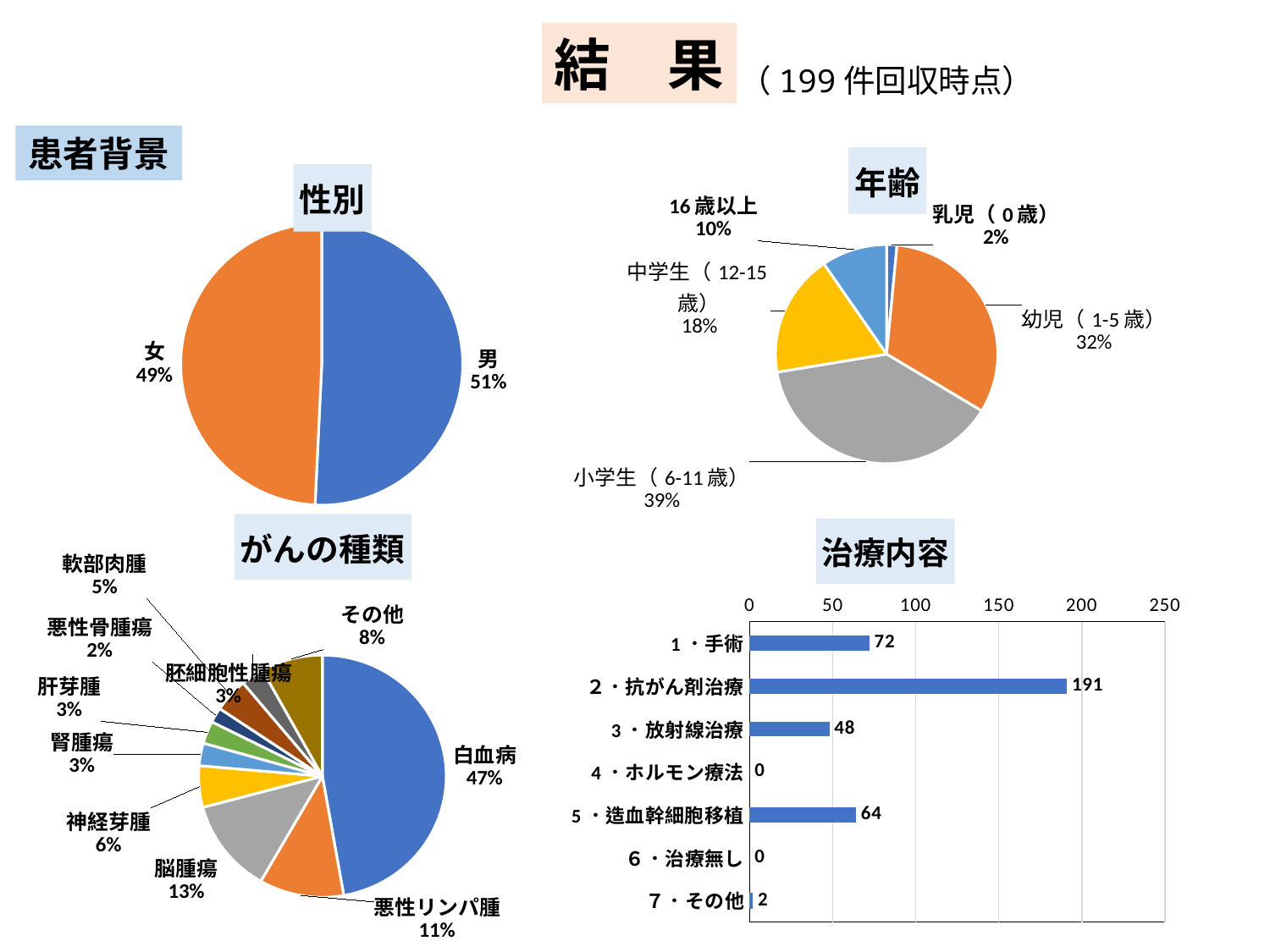
In the 年齢 pie chart, what is the difference in percentage points between 幼児（1-5歳） and 中学生（12-15歳）? 14 In the がんの種類 pie chart, what percentage is 白血病? 47% In the 治療内容 chart, what is the difference between 1・手術 and 5・造血幹細胞移植? 8 In the 性別 pie chart, which slice is larger, 男 or 女? 男 What kind of chart is the 治療内容 chart? bar chart In the 性別 pie chart, what percentage is 男? 51% In the 年齢 pie chart, how many age groups are shown? 5 In the 年齢 pie chart, which age group has the smallest share? 乳児（0歳） In the がんの種類 pie chart, which category has the largest share? 白血病 In the 治療内容 chart, what is the value for 2・抗がん剤治療? 191 In the 年齢 pie chart, what percentage is 小学生（6-11歳）? 39% In the がんの種類 pie chart, what percentage is 脳腫瘍? 13%